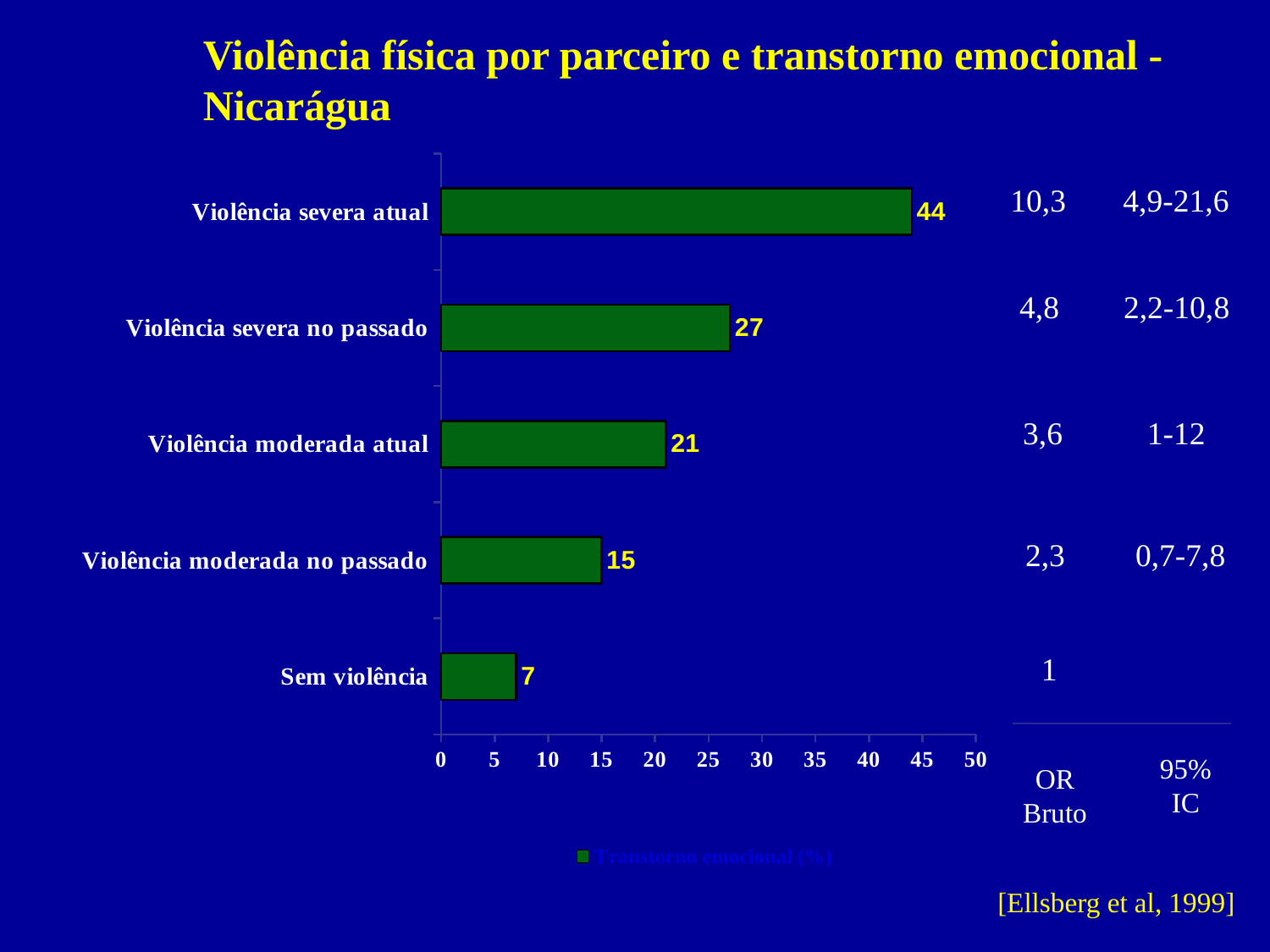
What is the value for "Violência moderada no passado"? 15 What is the title of the chart on the slide? Violência física por parceiro e transtorno emocional - Nicarágua Which category has the lowest value? Sem violência Which is larger, the value for "Violência severa no passado" or "Violência moderada atual"? Violência severa no passado How many categories are shown in the chart? 5 What is the value for "Violência severa atual"? 44 What is the value for "Sem violência"? 7 What is the difference between the values for "Violência moderada atual" and "Sem violência"? 14 What kind of chart is shown on the slide? bar chart Is the value for "Violência moderada atual" greater or less than 25? less What is the difference between the values for "Violência severa atual" and "Violência severa no passado"? 17 Which category has the highest value? Violência severa atual